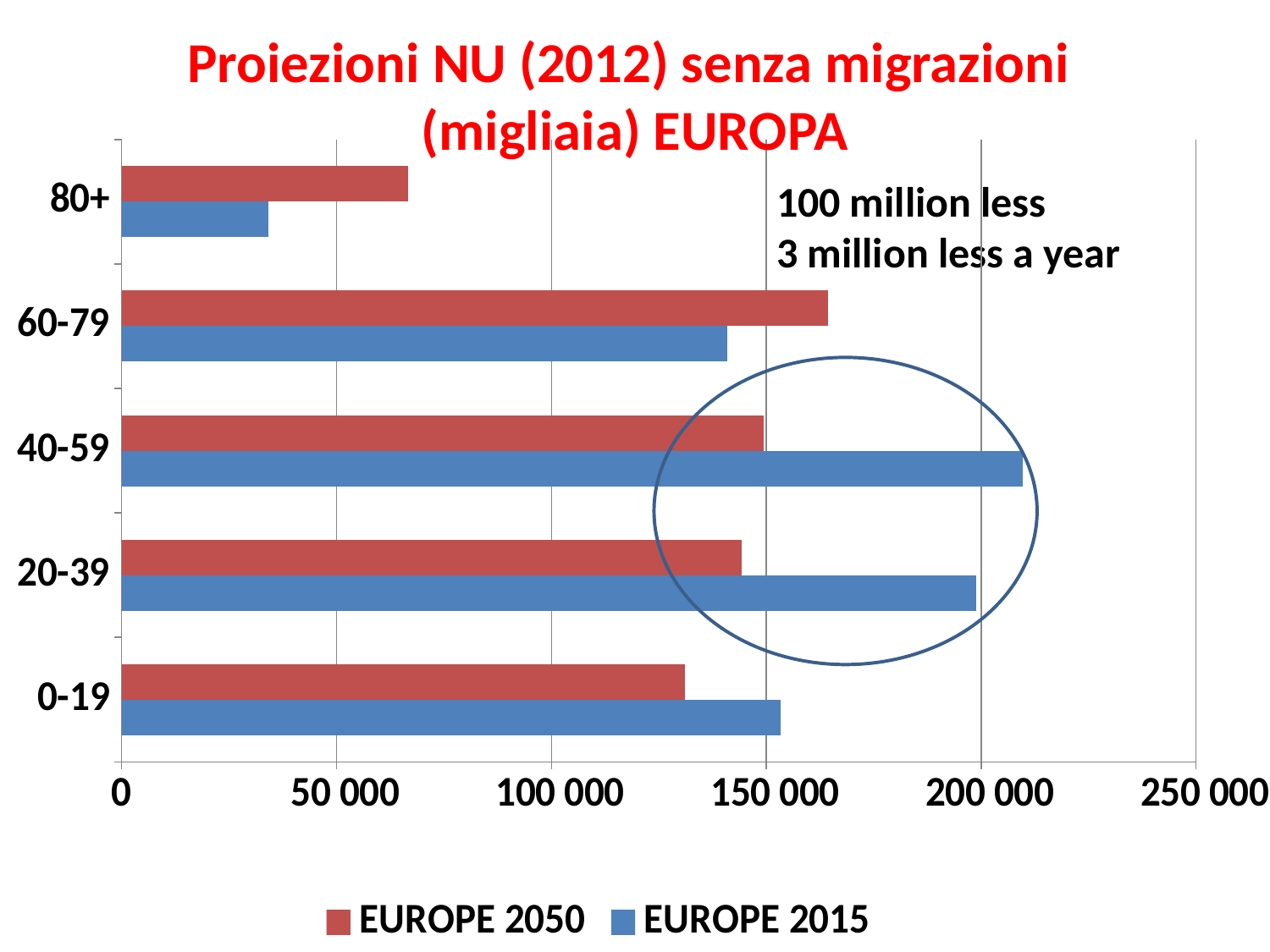
Is the EUROPE 2015 value for the 40-59 age group greater or less than 200 000? greater Which age group has the highest value for EUROPE 2050? 60-79 For the 40-59 age group, which is larger: EUROPE 2015 or EUROPE 2050? EUROPE 2015 What kind of chart is shown on the slide? bar chart Which age group has the highest value for EUROPE 2015? 40-59 How many age groups are shown on the chart? 5 For the 80+ age group, which is larger: EUROPE 2015 or EUROPE 2050? EUROPE 2050 Which age group has the lowest value for EUROPE 2050? 80+ Which series is shown in blue in the legend? EUROPE 2015 Which age group has the lowest value for EUROPE 2015? 80+ Is the EUROPE 2015 value for the 80+ age group greater or less than 50 000? less How many series does the legend list? 2